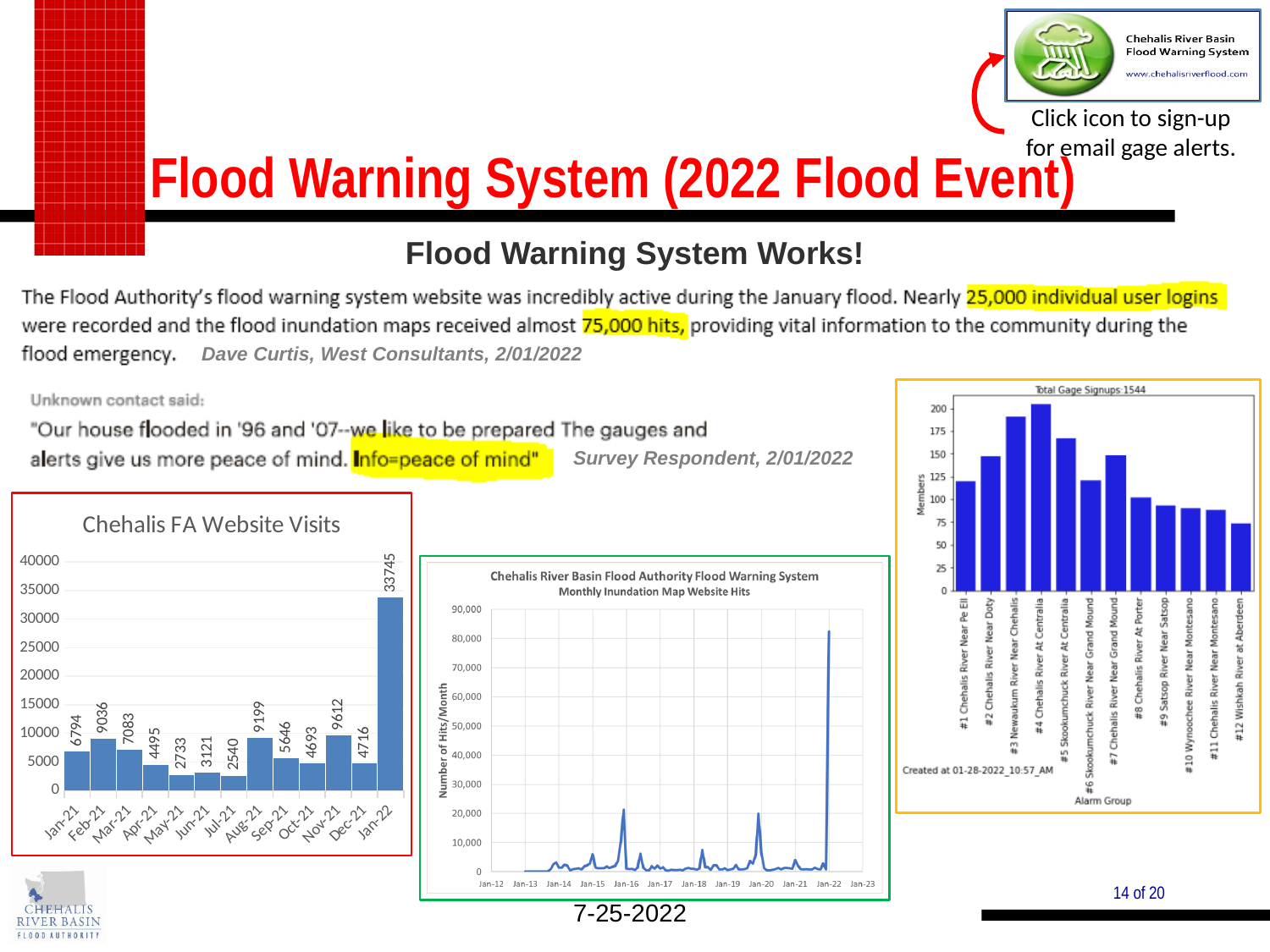
In the Chehalis FA Website Visits chart, which is larger, the value for Aug-21 or the value for Sep-21? Aug-21 How many months are shown in the Chehalis FA Website Visits chart? 13 In the Total Gage Signups chart, which alarm group has the most members? #4 Chehalis River At Centralia In the Total Gage Signups chart, is the value for #12 Wishkah River at Aberdeen greater or less than 100? less In the Chehalis FA Website Visits chart, what is the value for Jan-22? 33745 In the Chehalis FA Website Visits chart, which month has the highest value? Jan-22 In the Chehalis FA Website Visits chart, which month has the lowest value? Jul-21 In the Chehalis FA Website Visits chart, what is the value for Nov-21? 9612 In the Chehalis FA Website Visits chart, what is the difference between the values for Feb-21 and Jan-21? 2242 What kind of chart is the Monthly Inundation Map Website Hits chart? line chart In the Monthly Inundation Map Website Hits chart, is the peak value near Jan-22 greater or less than 70,000? greater What kind of chart is the Chehalis FA Website Visits chart? bar chart